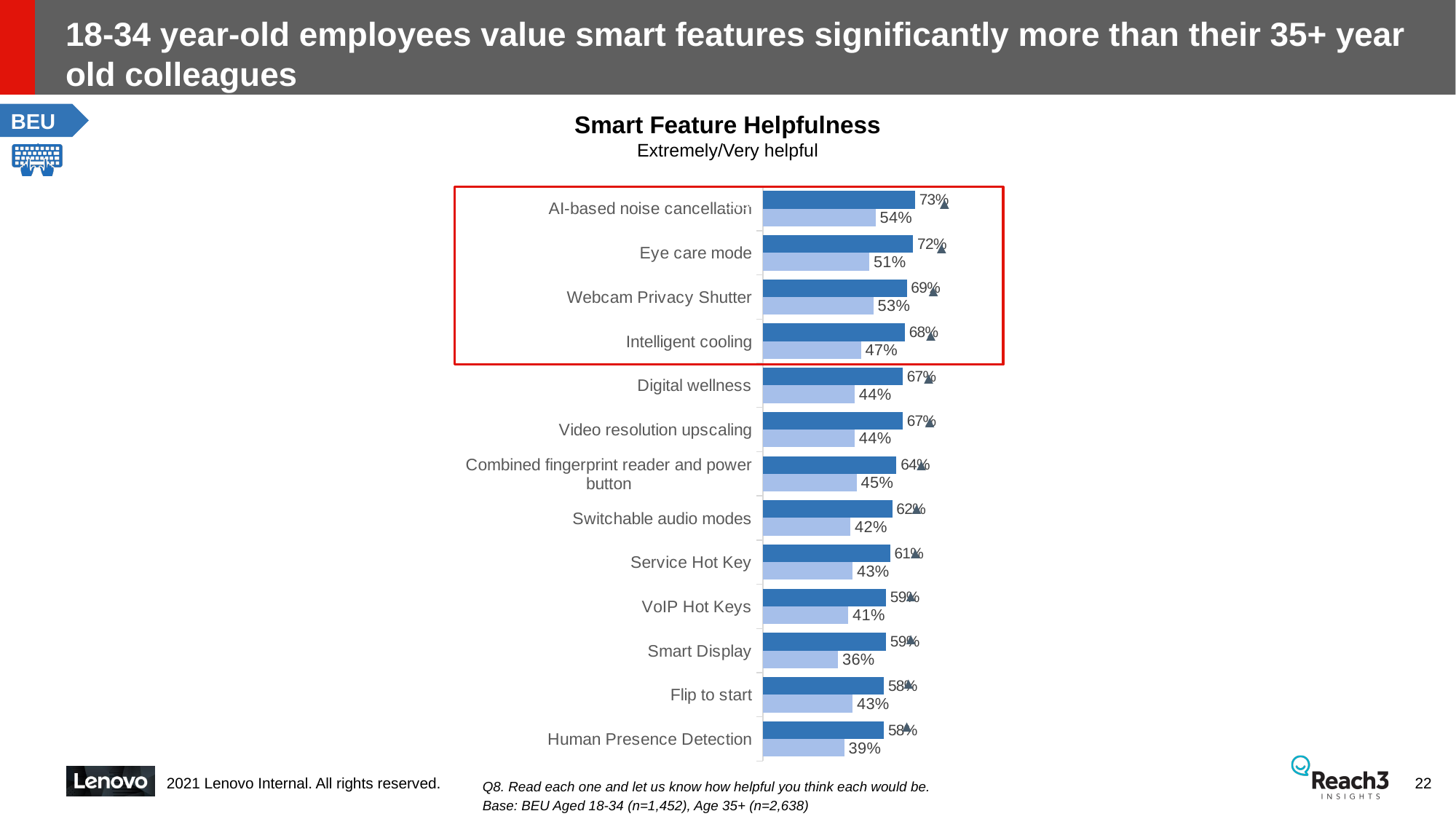
Which is larger: the light blue value for Webcam Privacy Shutter or the light blue value for Digital wellness? Webcam Privacy Shutter What is the difference between the dark blue and light blue values for Eye care mode? 21 percentage points What is the title of the chart? Smart Feature Helpfulness What is the difference between the dark blue and light blue values for Human Presence Detection? 19 percentage points Which feature has the highest dark blue bar value? AI-based noise cancellation What is the value of the light blue bar for Intelligent cooling? 47% What is the value of the light blue bar for Smart Display? 36% What is the value of the dark blue bar for Switchable audio modes? 62% Which feature has the lowest light blue bar value? Smart Display How many features are listed in the chart? 13 What is the value of the dark blue bar for AI-based noise cancellation? 73% What kind of chart is shown on the slide? Bar chart